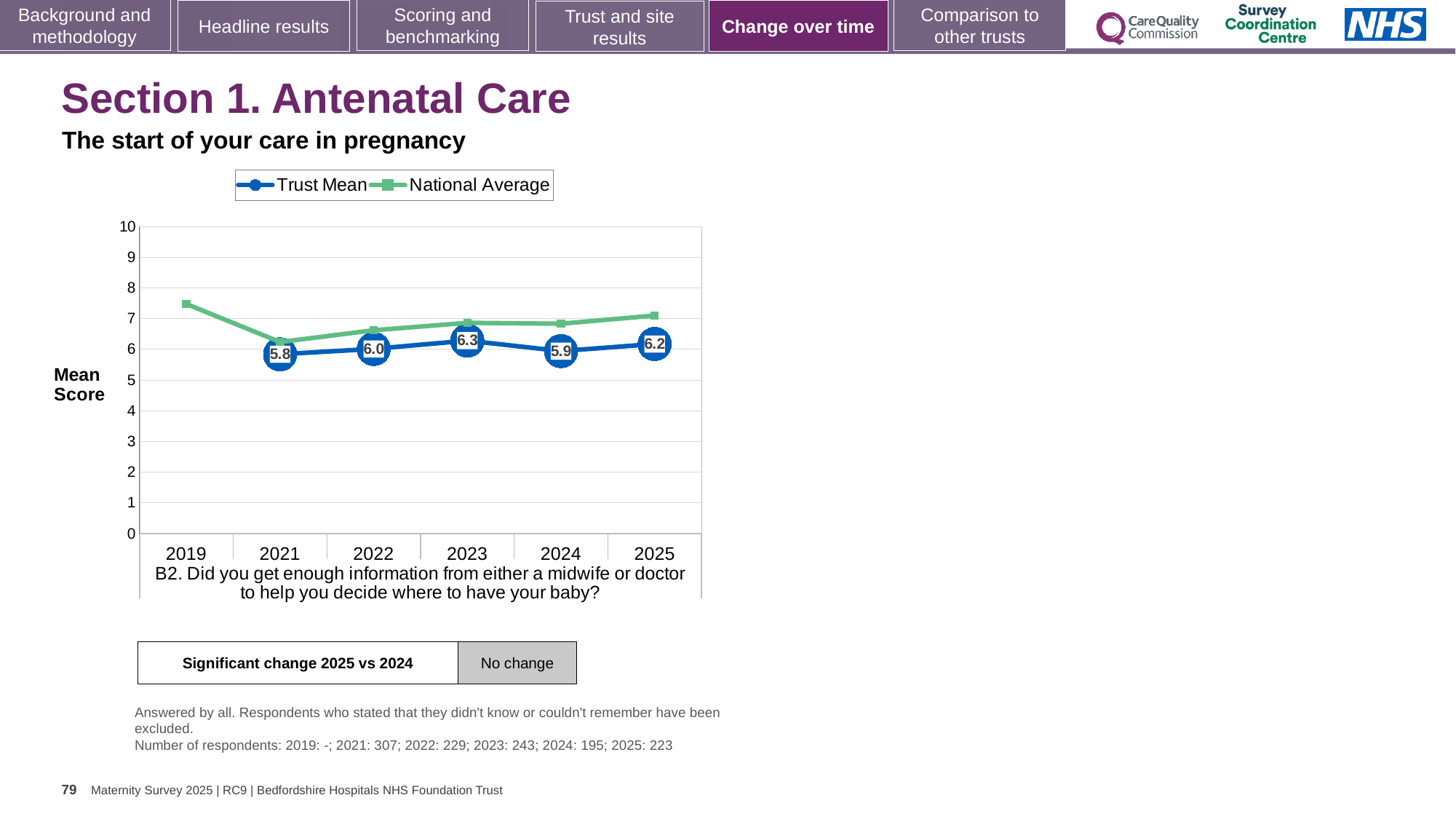
How many series does the legend list? 2 Which year has the larger Trust Mean score, 2024 or 2025? 2025 What is the Trust Mean score for 2021? 5.8 What is the difference between the Trust Mean scores for 2023 and 2021? 0.5 How many years are shown on the x axis of the chart? 6 Is the National Average value for 2019 greater or less than 7? greater What is the Trust Mean score for 2025? 6.2 Is the National Average value for 2021 greater or less than 7? less In which year is the Trust Mean score highest? 2023 In which year is the Trust Mean score lowest? 2021 What kind of chart is shown on the slide? line chart What is the Trust Mean score for 2023? 6.3